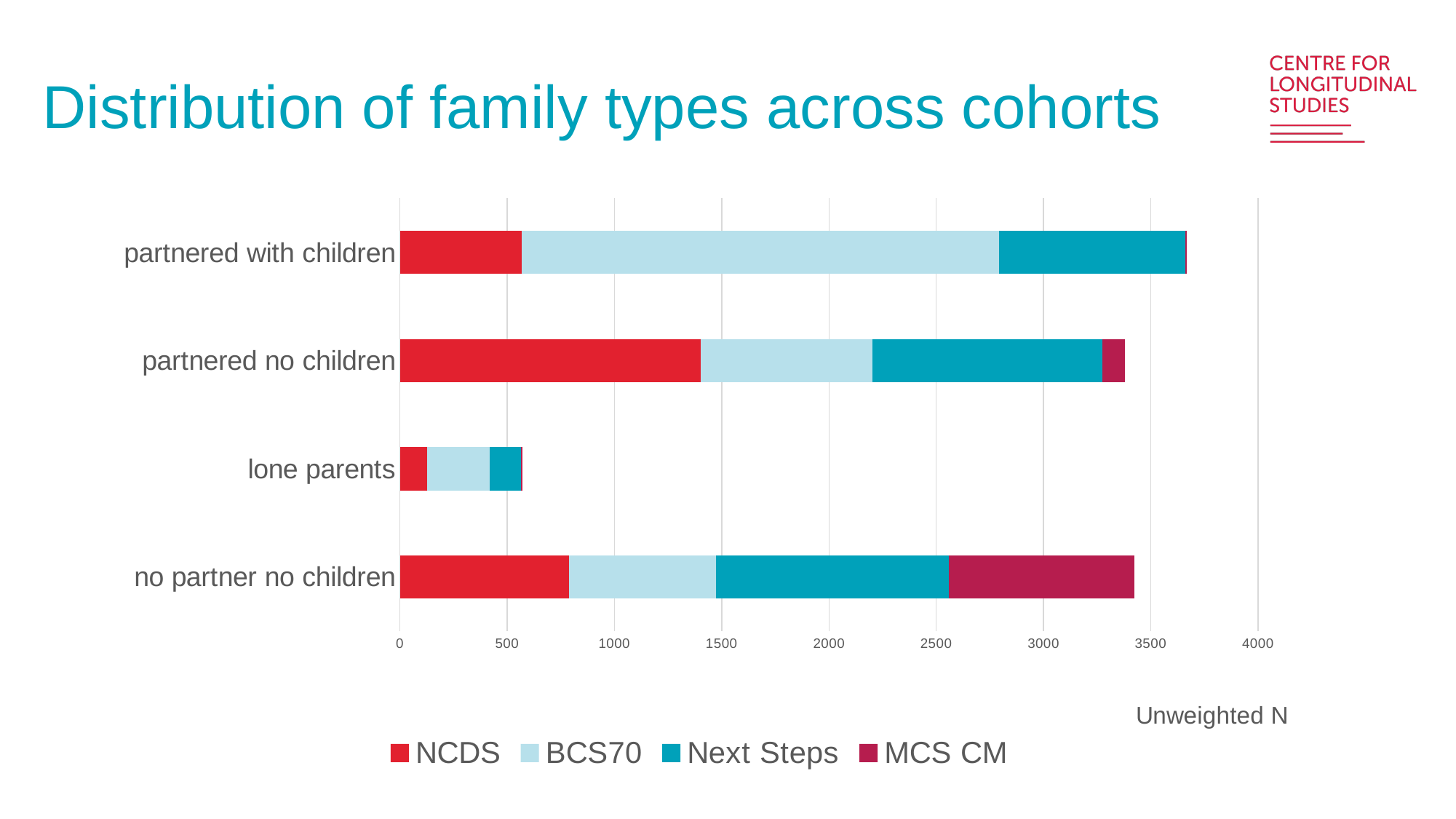
Is the NCDS value for partnered no children greater or less than 1000? greater Which family type has the lowest total bar length? lone parents Which family type has the highest total bar length? partnered with children How many family type categories are shown on the chart? 4 What kind of chart is shown on the slide? Stacked bar chart What label is shown on the horizontal axis of the chart? Unweighted N How many series does the legend list? 4 Which is larger: the NCDS segment for partnered no children or the NCDS segment for partnered with children? partnered no children Is the total for lone parents greater or less than 1000? less Which family type has the largest MCS CM segment? no partner no children Is the total for partnered with children greater or less than 3000? greater